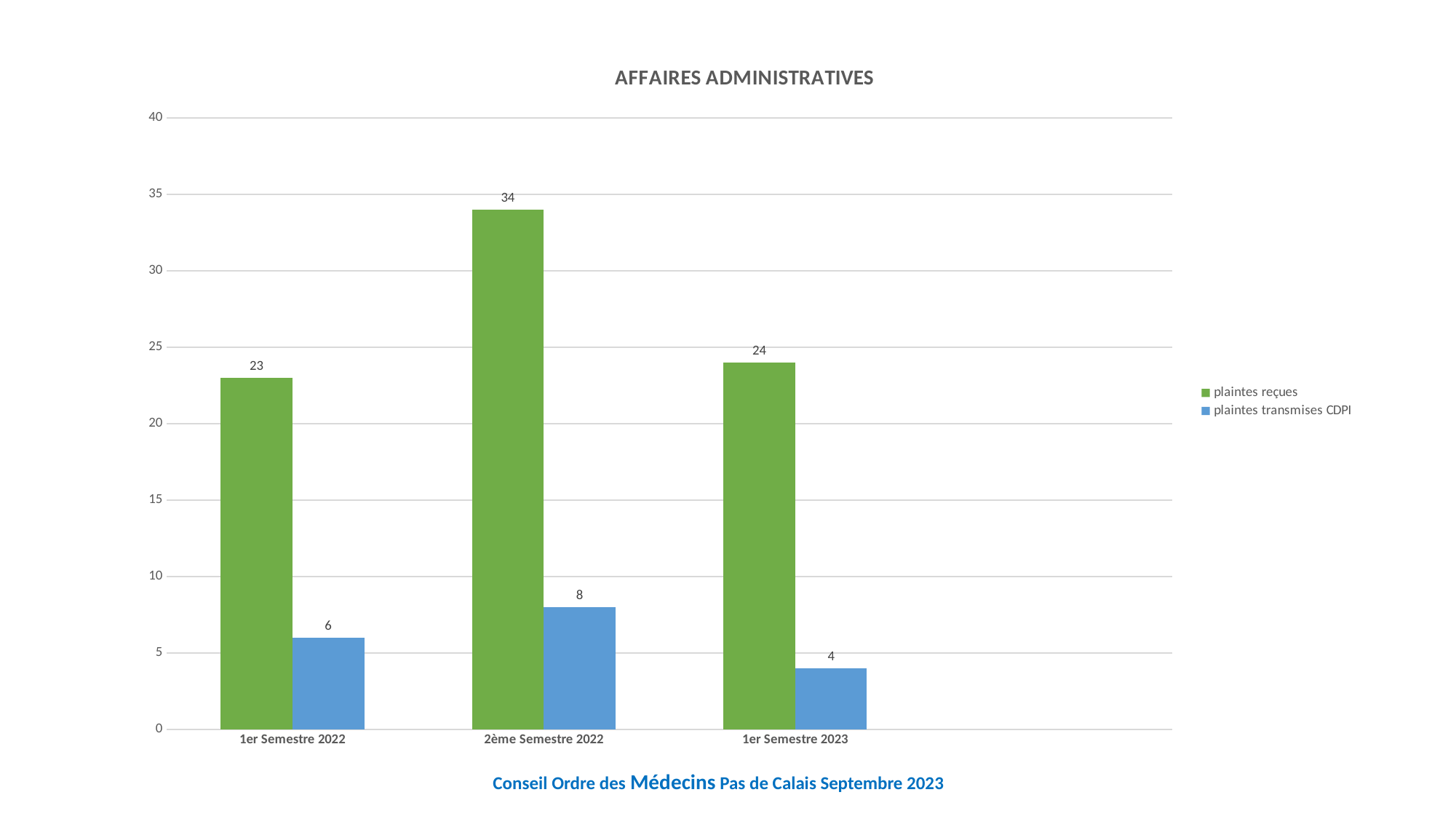
Is the value of plaintes reçues for 1er Semestre 2023 greater or less than 20? greater What is the value of plaintes transmises CDPI for 1er Semestre 2023? 4 What is the value of plaintes reçues for 1er Semestre 2022? 23 Which semester has the lowest value for plaintes transmises CDPI? 1er Semestre 2023 What is the title of the chart? AFFAIRES ADMINISTRATIVES Which is larger: plaintes transmises CDPI for 1er Semestre 2022 or for 2ème Semestre 2022? 2ème Semestre 2022 What is the difference between plaintes reçues and plaintes transmises CDPI for 2ème Semestre 2022? 26 How many series does the legend list? 2 Which semester has the highest value for plaintes reçues? 2ème Semestre 2022 How many semesters are shown on the x axis? 3 What kind of chart is shown on the slide? bar chart What is the value of plaintes reçues for 2ème Semestre 2022? 34